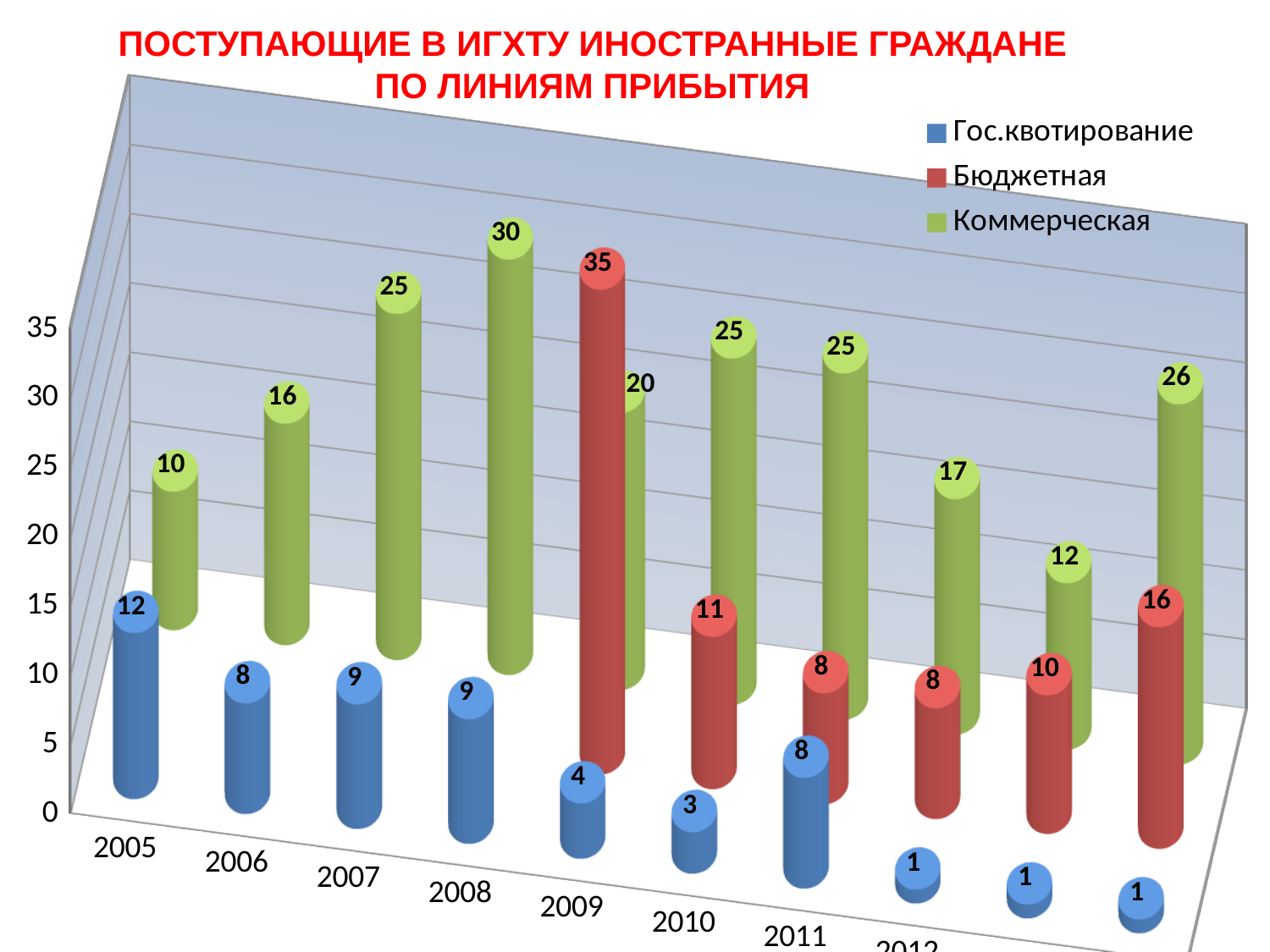
What colour represents the Коммерческая series? Green In which year is the Гос.квотирование value highest? 2005 Does the Гос.квотирование value generally rise or fall from 2005 to 2010? Fall What kind of chart is shown on the slide? Bar chart What is the difference between the Коммерческая values for 2007 and 2005? 15 How many series does the legend list? 3 In 2009, which is larger: Бюджетная or Коммерческая? Бюджетная In which year is the Коммерческая value highest? 2008 What is the value for Гос.квотирование in 2005? 12 What is the value for Коммерческая in 2008? 30 What is the value for Бюджетная in 2009? 35 What is the value for Бюджетная in 2010? 11